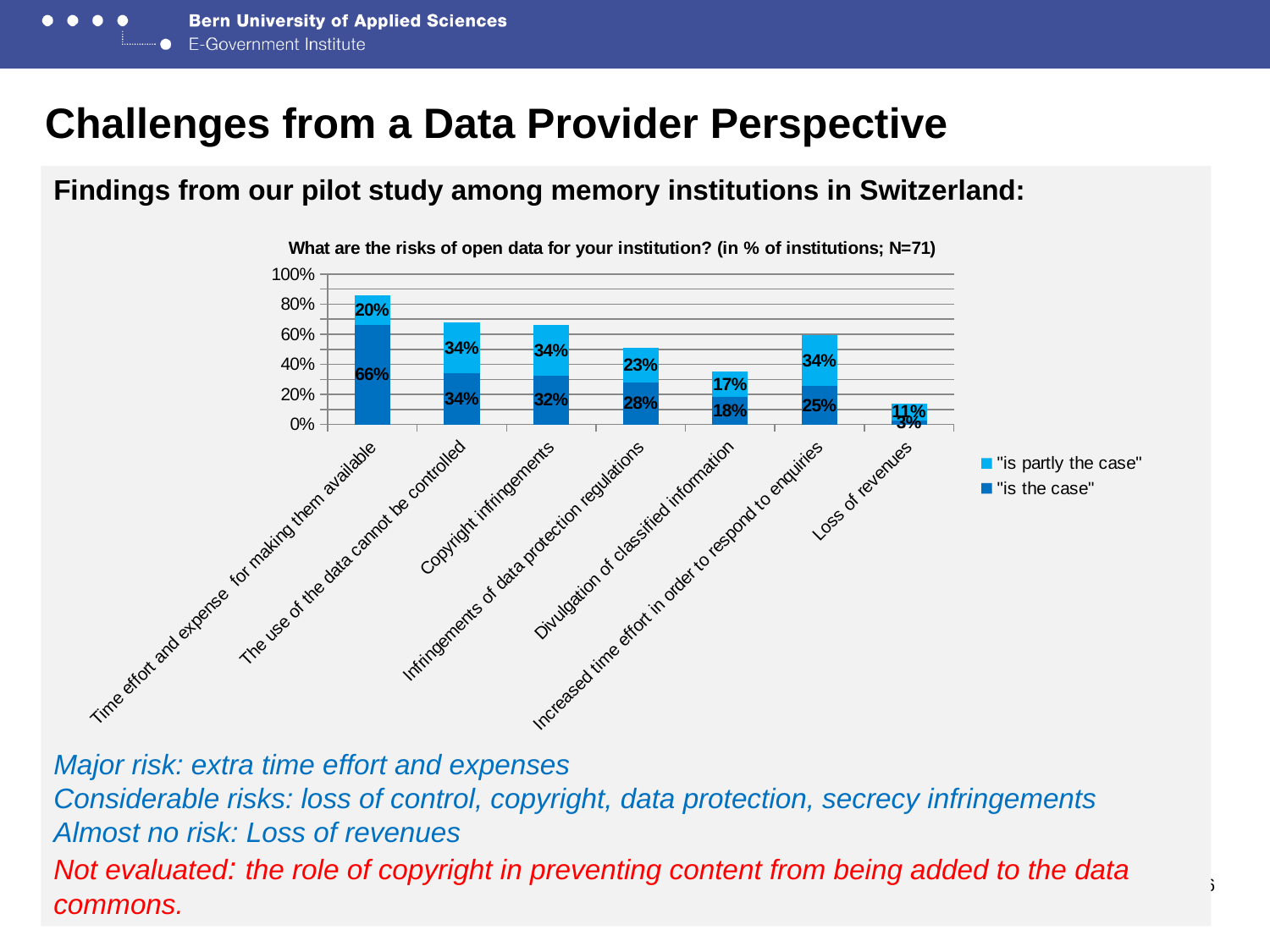
What is the "is partly the case" value for "Infringements of data protection regulations"? 23% What kind of chart is shown on the slide? stacked bar chart Which risk category has the highest "is the case" value? Time effort and expense for making them available How many risk categories are shown on the x axis of the chart? 7 Which risk category has the lowest total stacked value? Loss of revenues What is the "is the case" value for "Time effort and expense for making them available"? 66% What is the difference between the "is the case" values for "Time effort and expense for making them available" and "The use of the data cannot be controlled"? 32% Which is larger: the "is the case" value for "Increased time effort in order to respond to enquiries" or for "Divulgation of classified information"? Increased time effort in order to respond to enquiries How many series does the chart's legend list? 2 What is the title of the chart? What are the risks of open data for your institution? (in % of institutions; N=71) What is the total stacked value for "Copyright infringements"? 66% What is the "is the case" value for "Loss of revenues"? 3%